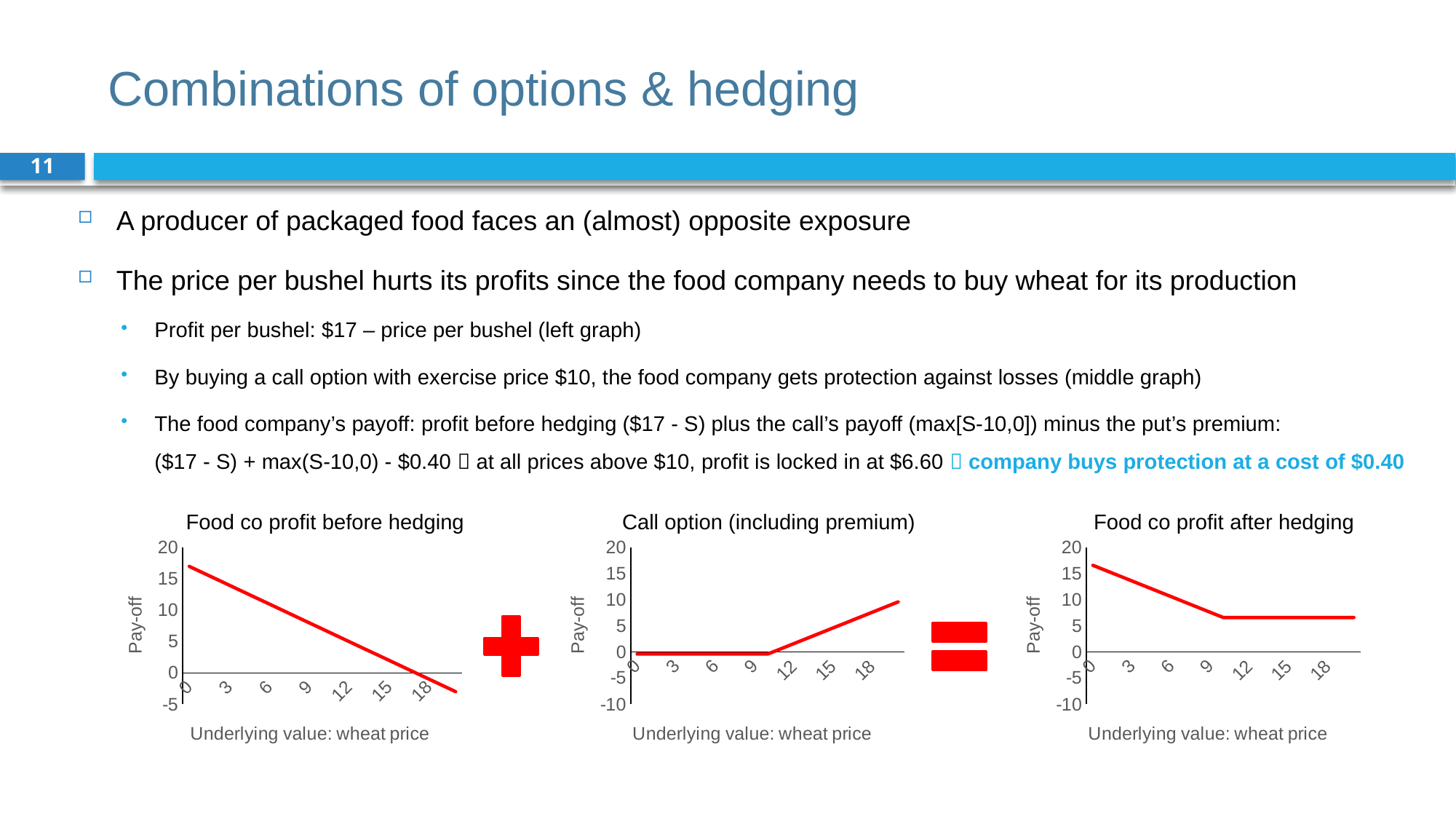
In the 'Call option (including premium)' chart, does the pay-off rise or fall as the wheat price increases from 12 to 18? rise In the 'Food co profit after hedging' chart, is the pay-off at a wheat price of 15 greater or less than 5? greater In the 'Food co profit before hedging' chart, is the pay-off at a wheat price of 18 greater or less than 5? less In the 'Call option (including premium)' chart, is the pay-off at a wheat price of 18 greater or less than 5? greater In the 'Food co profit before hedging' chart, does the pay-off rise or fall as the wheat price increases along the x axis? fall What is the y-axis label of the 'Call option (including premium)' chart? Pay-off In the 'Food co profit after hedging' chart, does the pay-off rise or fall as the wheat price increases from 0 to 9? fall What is the x-axis label of the 'Food co profit after hedging' chart? Underlying value: wheat price What kind of chart is the 'Food co profit before hedging' chart on the left? line chart